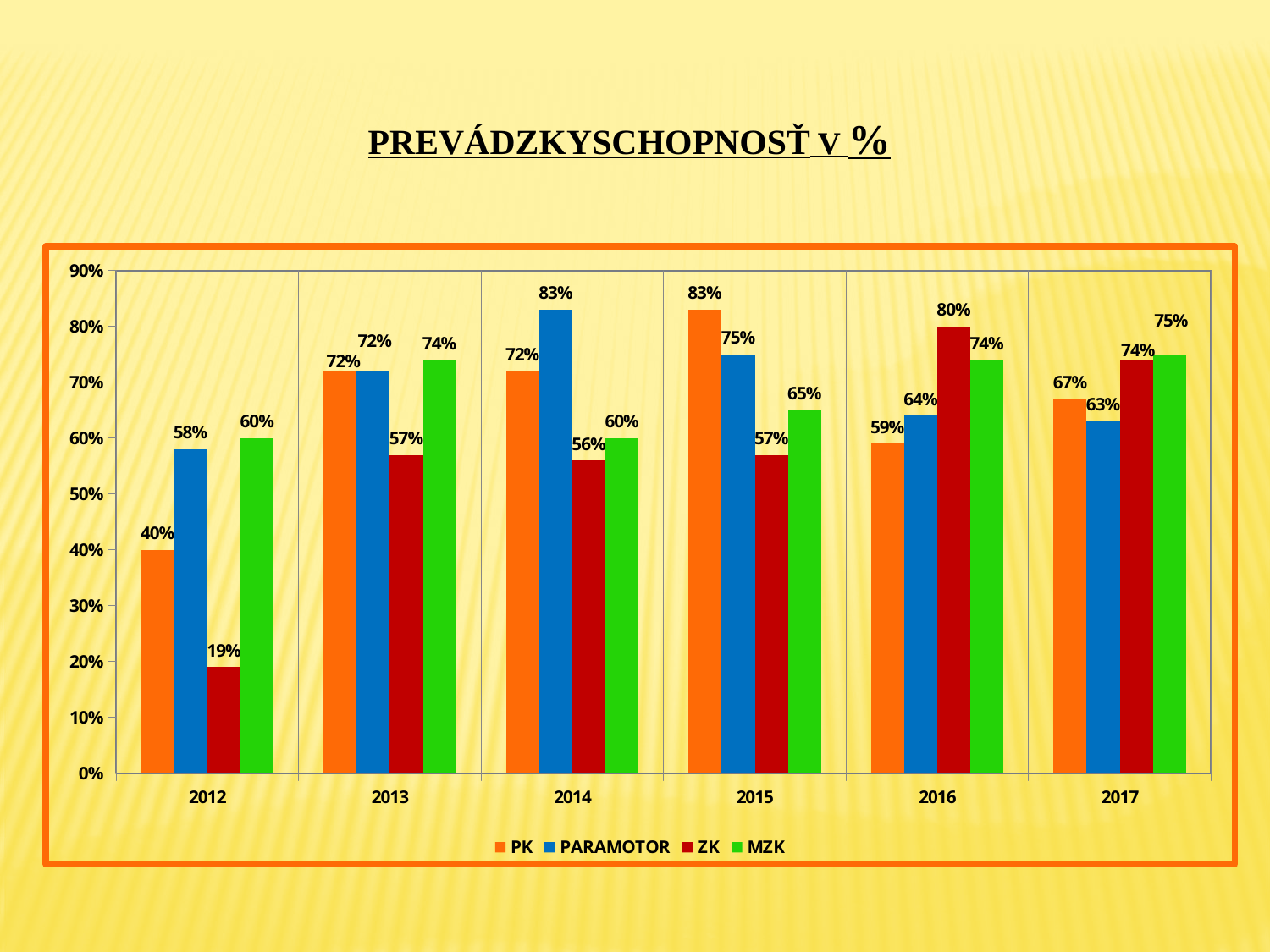
What is the value for ZK in 2012? 19% What kind of chart is shown on the slide? Bar chart What is the difference between the ZK value in 2016 and the ZK value in 2012? 61% How many series does the legend list? 4 In which year is the value for PK the highest? 2015 What is the value for MZK in 2017? 75% Does the value for ZK rise or fall from 2015 to 2016? Rise How many years are shown on the x axis? 6 In which year is the value for ZK the lowest? 2012 What is the value for PARAMOTOR in 2014? 83% What is the value for PK in 2016? 59% Which is larger in 2017, the value for PK or the value for PARAMOTOR? PK